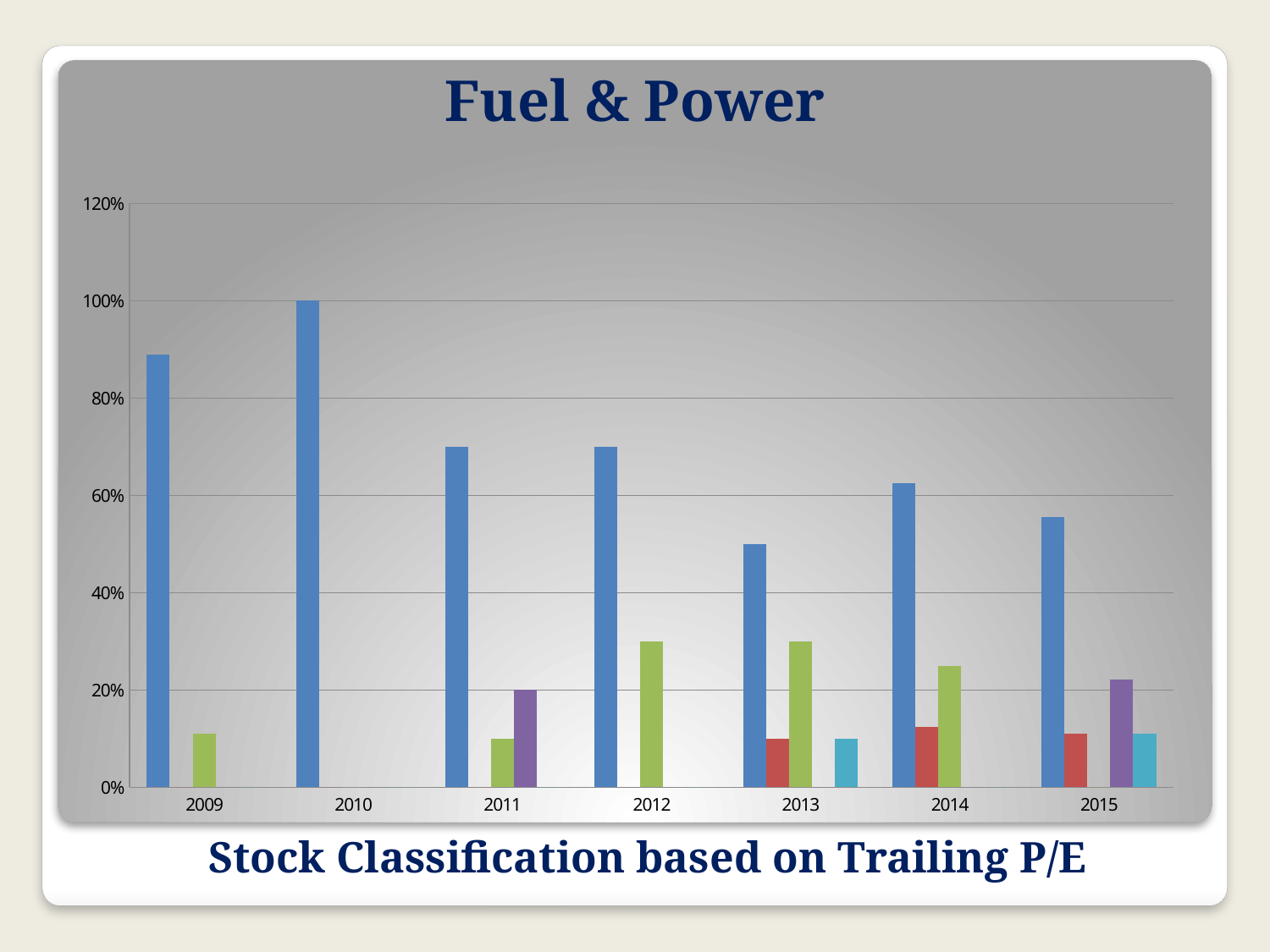
What is the title of the chart? Fuel & Power Is the value of the blue bar for 2009 greater or less than 80%? greater What kind of chart is shown on the slide? bar chart Is the value of the green bar for 2012 greater or less than 20%? greater Which year has the larger blue bar, 2014 or 2015? 2014 In which year is the blue bar the tallest? 2010 How many years are shown on the x axis of the chart? 7 Do the blue bars rise or fall from 2010 to 2013? fall What is the value of the blue bar for 2010? 100% In which year is the blue bar the shortest? 2013 How many bars are plotted for 2015? 4 Is the value of the blue bar for 2013 greater or less than 60%? less